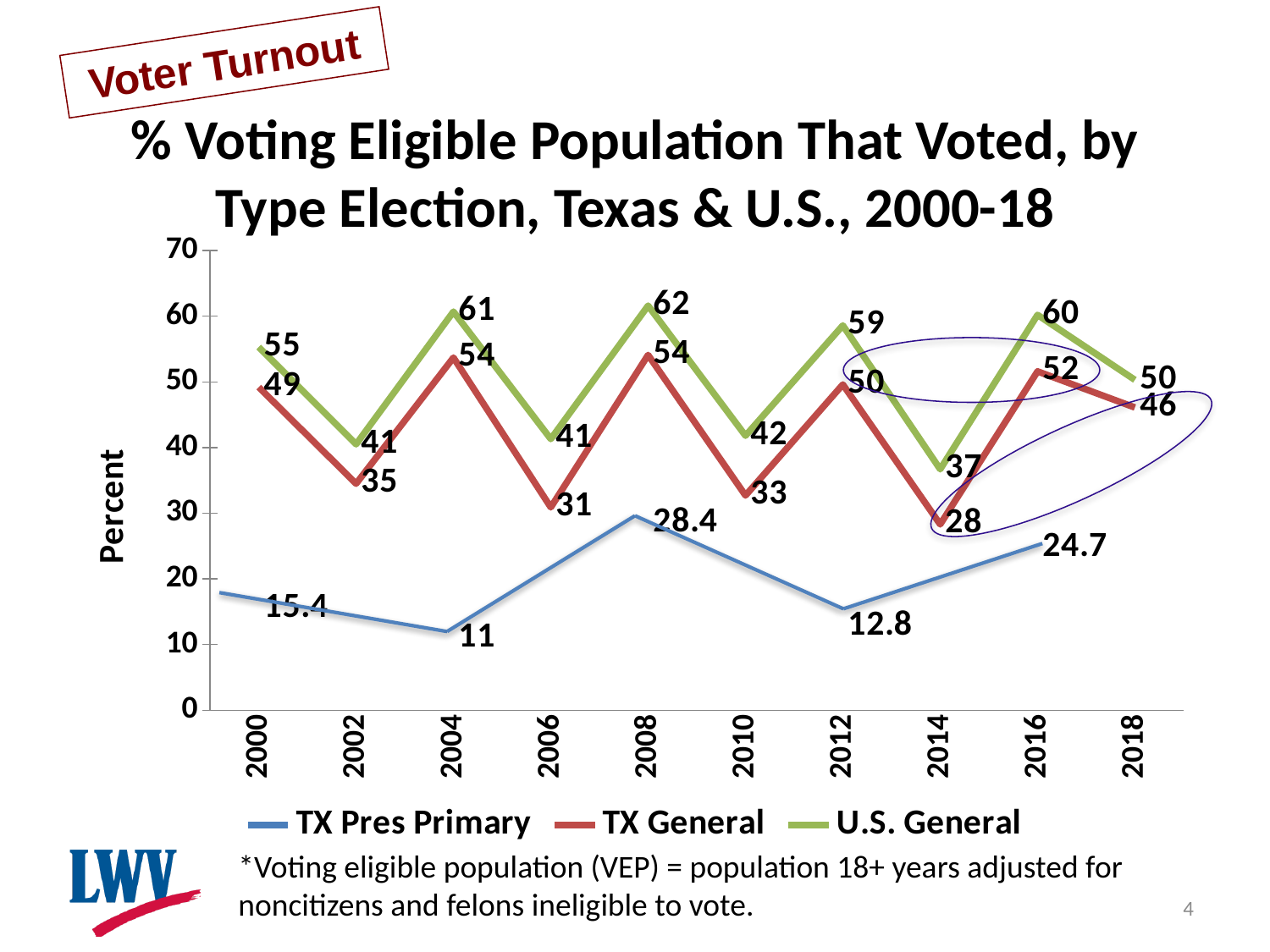
What type of chart is shown on the slide? line chart What was the TX General turnout in 2014? 28 Which was higher in 2012: TX General or U.S. General turnout? U.S. General Did the TX General turnout rise or fall from 2016 to 2018? fall What was the TX Pres Primary turnout in 2016? 24.7 In which year was the TX General turnout lowest? 2014 How many years are shown on the x axis? 10 In which year was the TX Pres Primary turnout highest? 2008 What is the label on the y axis? Percent How many series does the legend list? 3 What was the U.S. General turnout in 2008? 62 What is the difference between the U.S. General and TX General turnout in 2018? 4